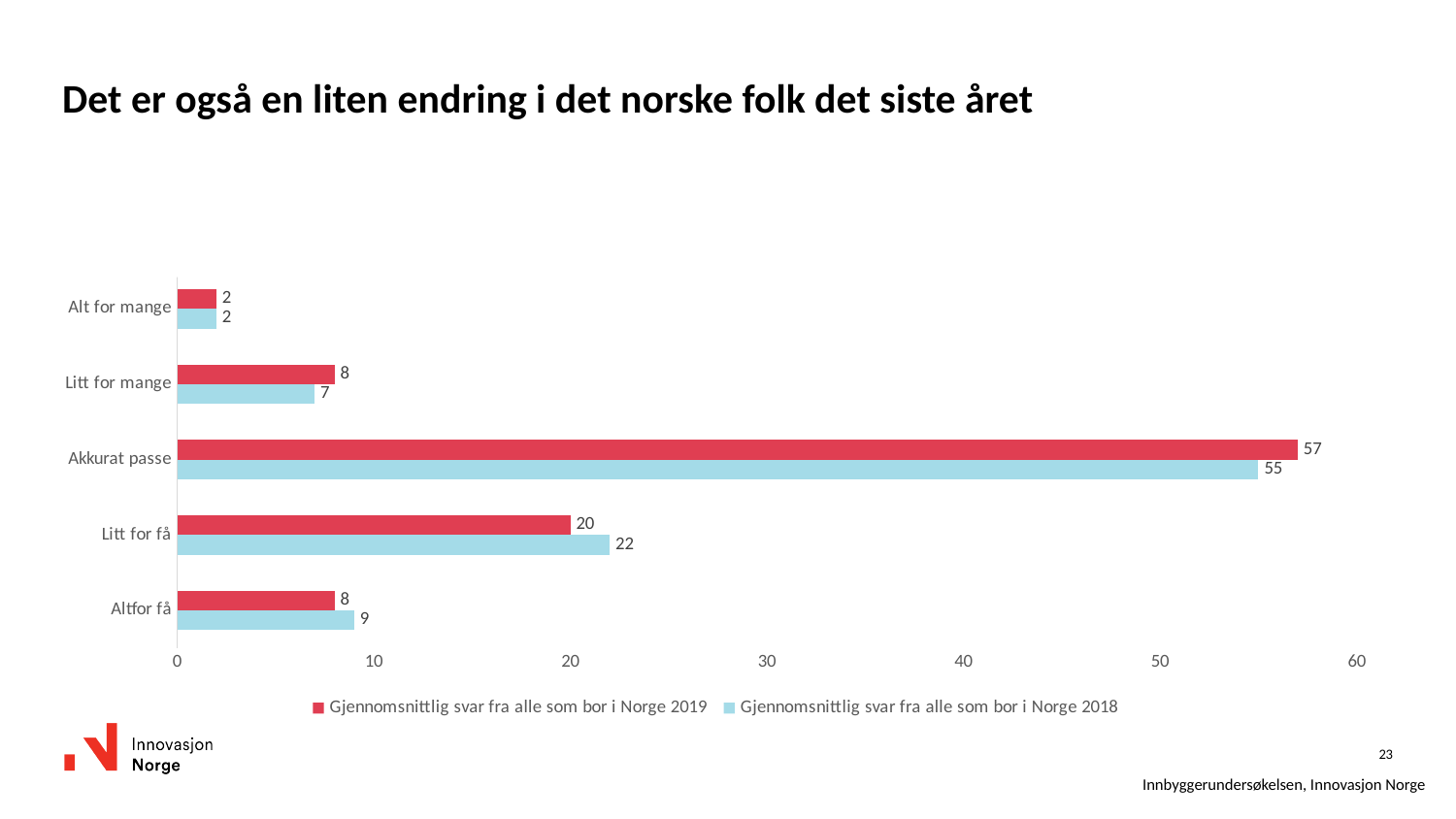
What is the 2019 value for 'Akkurat passe'? 57 What is the difference between the 2019 and 2018 values for 'Akkurat passe'? 2 What is the 2018 value for 'Litt for få'? 22 What is the 2018 value for 'Litt for mange'? 7 For 'Altfor få', which year has the larger value, 2019 or 2018? 2018 How many series does the legend list? 2 What is the difference between the 2018 and 2019 values for 'Litt for få'? 2 Which category has the highest 2019 value? Akkurat passe How many categories are shown on the chart? 5 Is the 2018 value for 'Akkurat passe' greater or less than 50? greater Which category has the lowest 2018 value? Alt for mange What kind of chart is shown on the slide? Bar chart